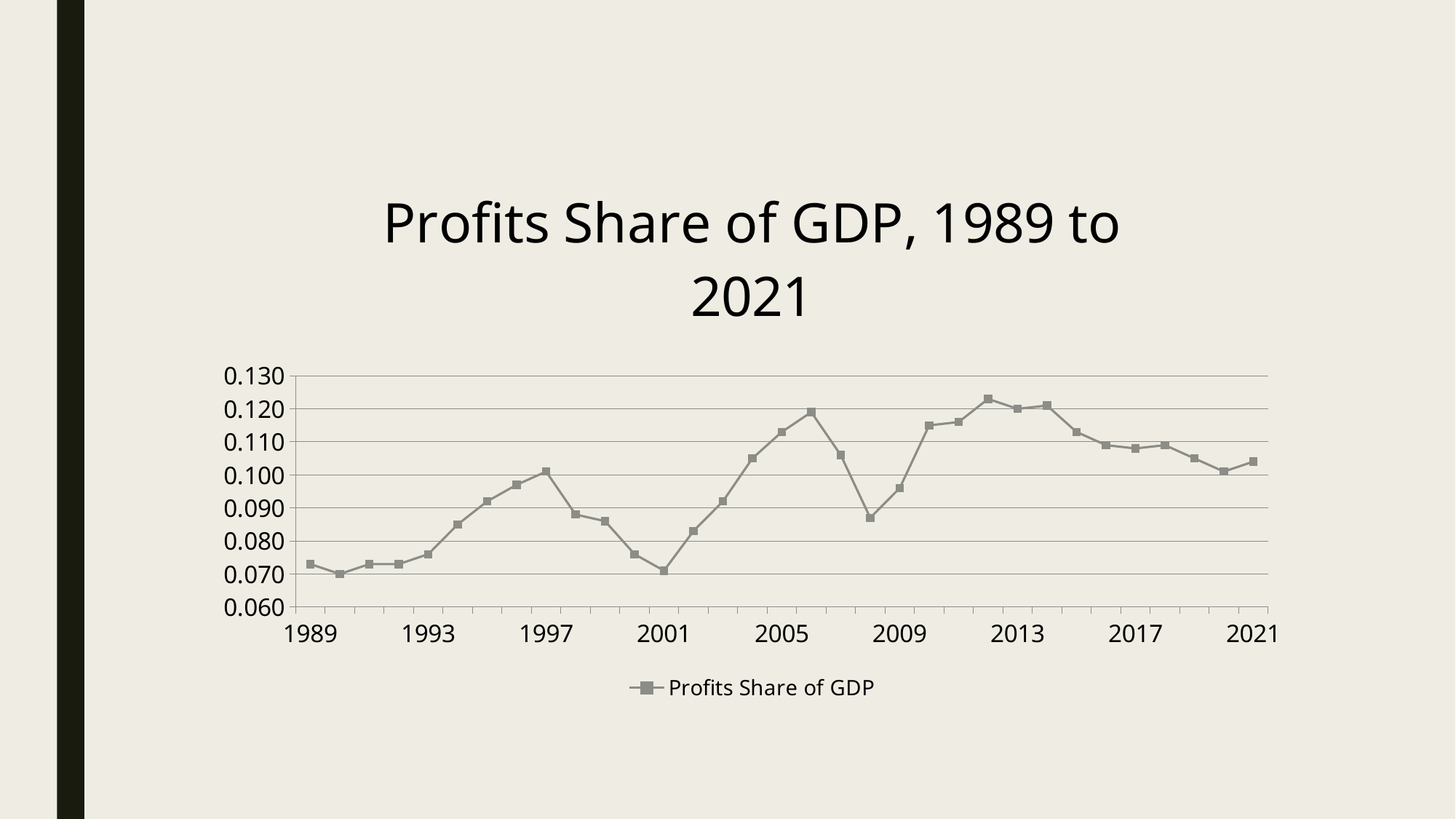
How many data points are plotted on the line? 33 Which year has the larger value, 2001 or 2006? 2006 Is the value for 2006 greater or less than 0.110? greater Do the values rise or fall from 2001 to 2006? rise Is the value for 1989 greater or less than 0.080? less Is the value for 2021 greater or less than 0.100? greater What kind of chart is shown on the slide? line chart How many series does the legend list? 1 What is the name of the series shown in the legend? Profits Share of GDP What is the title of the chart? Profits Share of GDP, 1989 to 2021 Which year has the larger value, 1989 or 2021? 2021